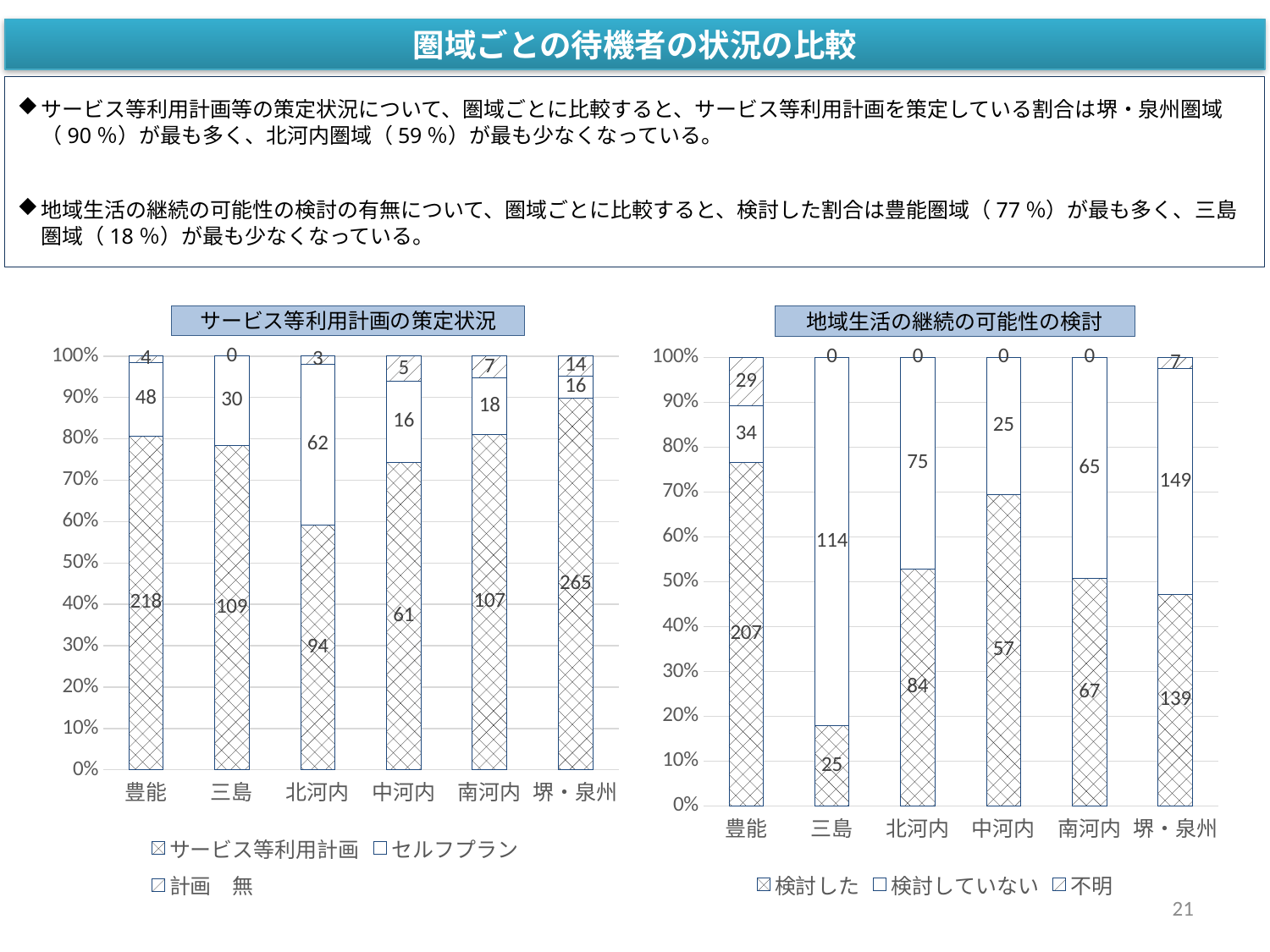
What kind of chart is the chart titled 地域生活の継続の可能性の検討? stacked bar chart In the chart titled サービス等利用計画の策定状況, what is the total of the three segments for 中河内? 82 In the chart titled 地域生活の継続の可能性の検討, what is the difference between 検討していない and 検討した for 北河内? 9 In the chart titled サービス等利用計画の策定状況, how many series does the legend list? 3 In the chart titled サービス等利用計画の策定状況, what is the value of セルフプラン for 北河内? 62 In the chart titled 地域生活の継続の可能性の検討, what is the value of 検討した for 三島? 25 In the chart titled 地域生活の継続の可能性の検討, is the 検討した share for 豊能 greater or less than 70%? greater In the chart titled サービス等利用計画の策定状況, which region has the highest value for サービス等利用計画? 堺・泉州 In the chart titled 地域生活の継続の可能性の検討, what is the value of 検討していない for 堺・泉州? 149 In the chart titled サービス等利用計画の策定状況, what is the value of サービス等利用計画 for 豊能? 218 In the chart titled 地域生活の継続の可能性の検討, how many regions are shown on the x axis? 6 In the chart titled 地域生活の継続の可能性の検討, which region has the lowest value for 検討した? 三島